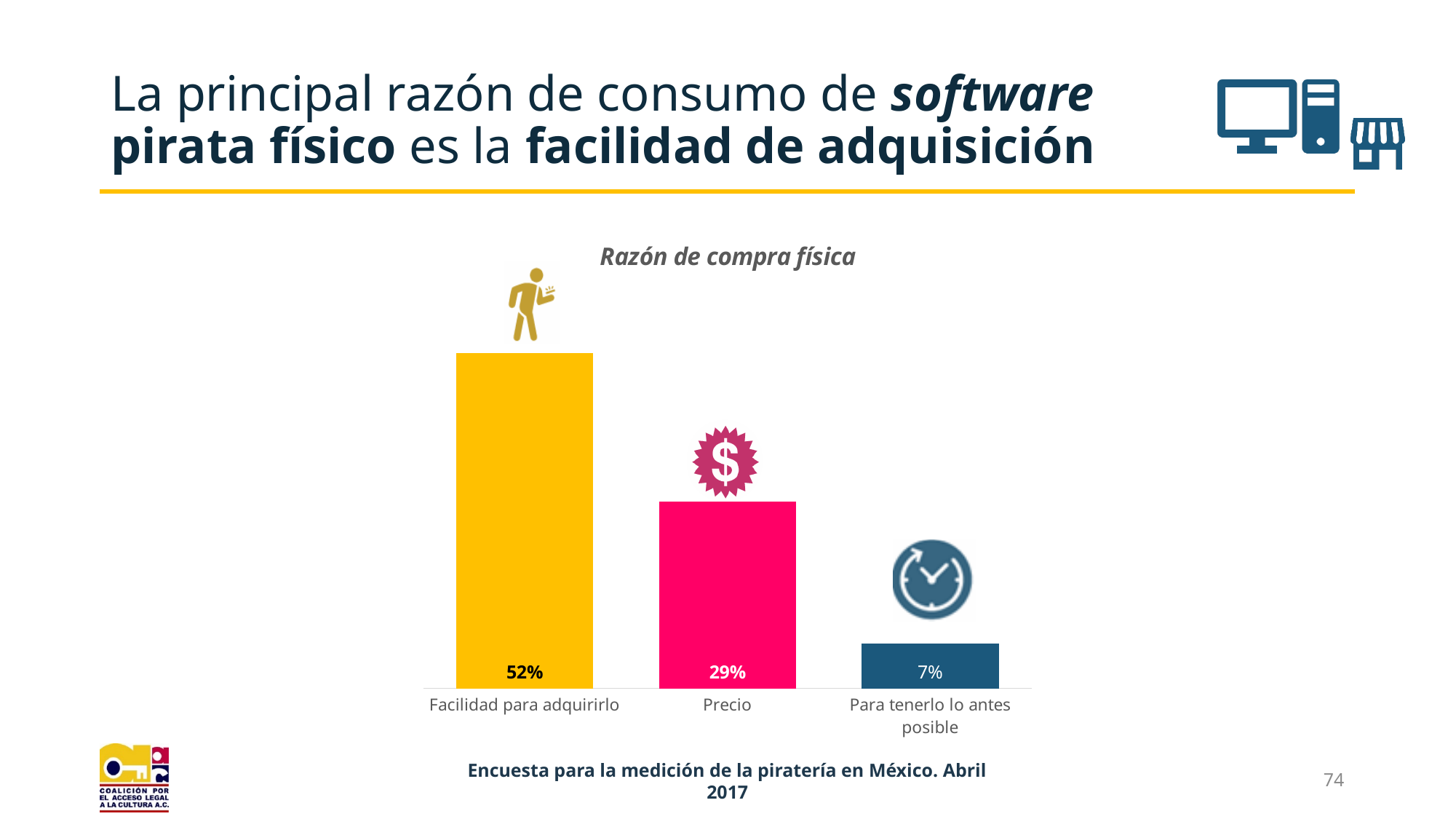
Which is larger, the value for "Precio" or the value for "Para tenerlo lo antes posible"? Precio What kind of chart is shown on the slide? Bar chart What is the difference between the values for "Facilidad para adquirirlo" and "Precio"? 23% What is the value for "Facilidad para adquirirlo"? 52% Which category has the highest value? Facilidad para adquirirlo What is the value for "Para tenerlo lo antes posible"? 7% What is the value for "Precio"? 29% What is the title of the chart? Razón de compra física What is the difference between the values for "Precio" and "Para tenerlo lo antes posible"? 22% How many categories are shown in the chart? 3 Which category has the lowest value? Para tenerlo lo antes posible Do the values rise or fall from left to right across the categories? Fall